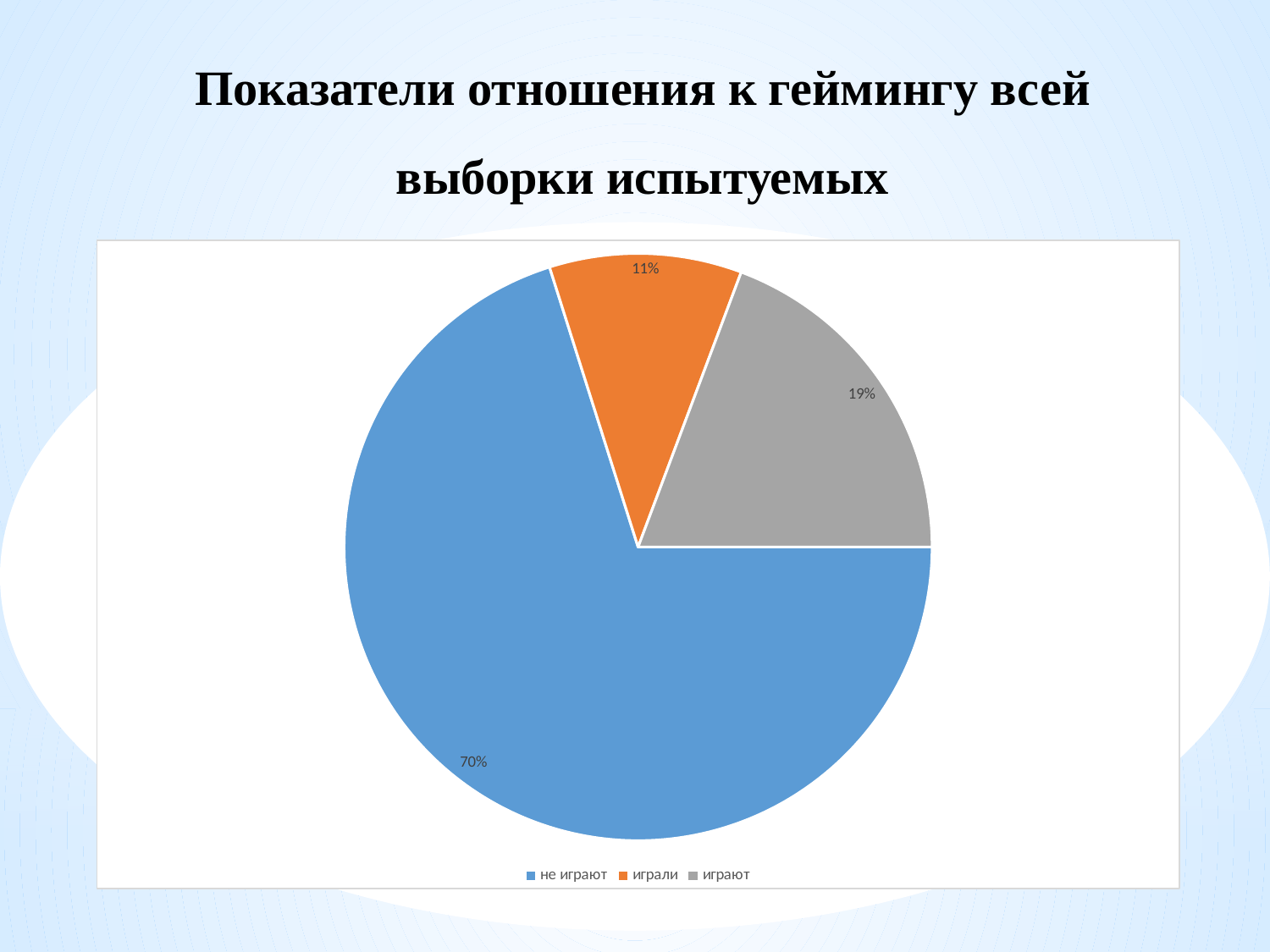
What colour is the 'играют' slice? grey What share of the pie does the 'играют' slice represent? 19% How many categories does the pie chart have? 3 What share of the pie does the 'не играют' slice represent? 70% What type of chart is shown on the slide? pie chart What share of the pie does the 'играли' slice represent? 11% Which slice is larger, 'играли' or 'играют'? играют Which category has the largest slice of the pie? не играют What is the title of the slide containing the chart? Показатели отношения к геймингу всей выборки испытуемых Which category has the smallest slice of the pie? играли What is the difference in percentage points between the 'не играют' slice and the 'играют' slice? 51 What is the difference in percentage points between the 'играют' slice and the 'играли' slice? 8